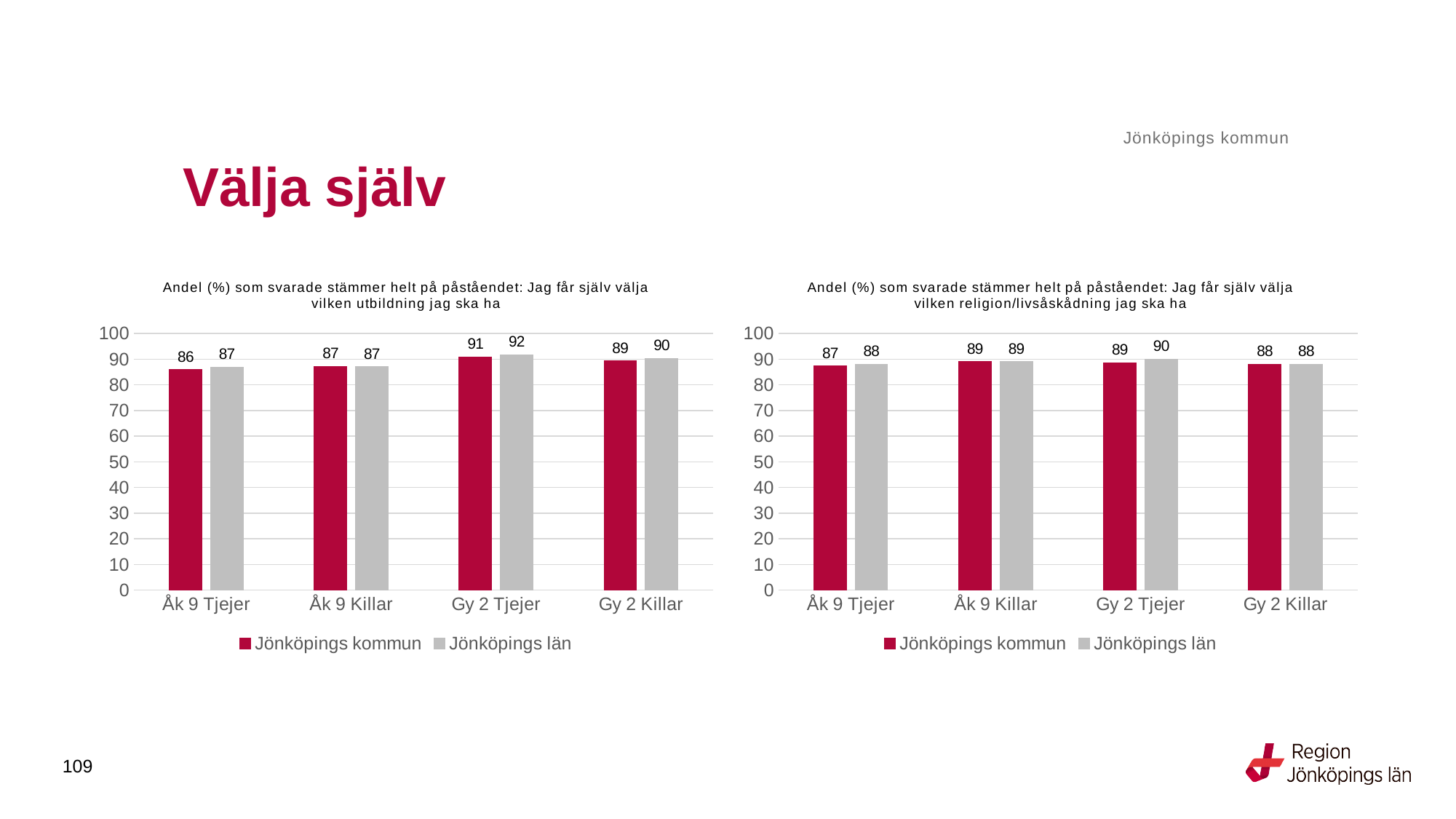
In the left chart (about choosing education), how many categories are shown on the x axis? 4 In the right chart (about choosing religion/livsåskådning), what is the value for Jönköpings kommun for Åk 9 Tjejer? 87 In the right chart (about choosing religion/livsåskådning), which colour represents Jönköpings län? Grey In the right chart (about choosing religion/livsåskådning), how many series does the legend list? 2 In the left chart (about choosing education), which category has the lowest value for Jönköpings kommun? Åk 9 Tjejer In the left chart (about choosing education), what is the difference between Jönköpings län and Jönköpings kommun for Gy 2 Tjejer? 1 What kind of chart is the left chart (about choosing education)? Bar chart In the left chart (about choosing education), what is the value for Jönköpings län for Gy 2 Tjejer? 92 In the right chart (about choosing religion/livsåskådning), what is the difference between Jönköpings kommun for Åk 9 Killar and Jönköpings kommun for Åk 9 Tjejer? 2 In the left chart (about choosing education), which category has the highest value for Jönköpings kommun? Gy 2 Tjejer In the left chart (about choosing education), what is the value for Jönköpings kommun for Åk 9 Tjejer? 86 In the right chart (about choosing religion/livsåskådning), what is the value for Jönköpings län for Gy 2 Tjejer? 90